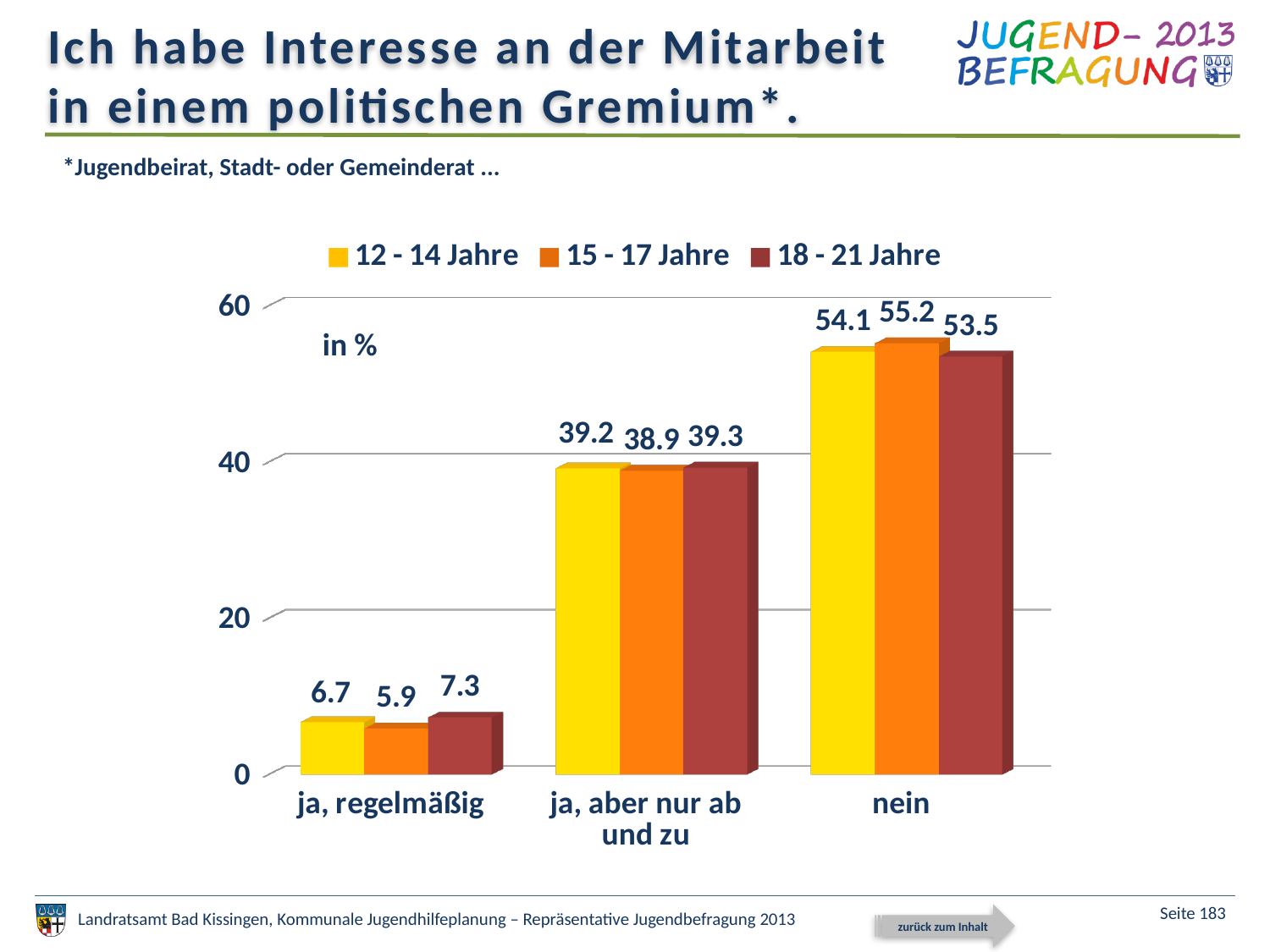
How many categories are shown on the x axis? 3 What is the difference between the 15 - 17 Jahre and 18 - 21 Jahre values in the "nein" category? 1.7 Which category has the lowest value for the 15 - 17 Jahre series? ja, regelmäßig What is the value for the 18 - 21 Jahre series in the "ja, aber nur ab und zu" category? 39.3 What kind of chart is shown on the slide? bar chart What is the value for the 15 - 17 Jahre series in the "nein" category? 55.2 Is the value for 12 - 14 Jahre in the "nein" category greater or less than 40? greater How many series does the legend list? 3 What is the value for the 12 - 14 Jahre series in the "ja, regelmäßig" category? 6.7 Which category has the highest value for the 18 - 21 Jahre series? nein Which series is shown in yellow? 12 - 14 Jahre In the "ja, regelmäßig" category, which series has the larger value: 12 - 14 Jahre or 18 - 21 Jahre? 18 - 21 Jahre